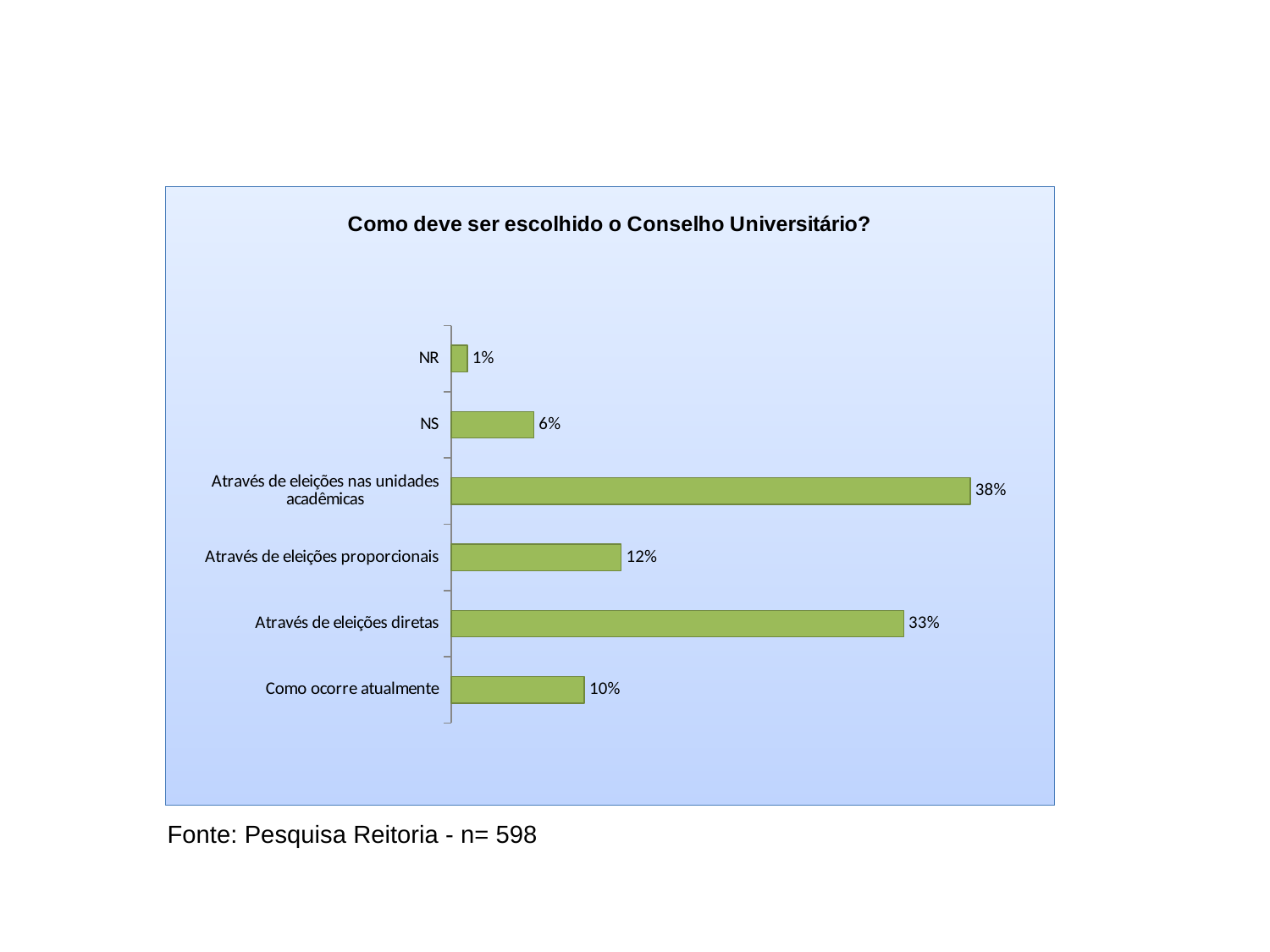
What is the difference between "Através de eleições proporcionais" and "NS"? 6% What is the value for "Através de eleições diretas"? 33% What is the title of the chart? Como deve ser escolhido o Conselho Universitário? What is the value for "Através de eleições nas unidades acadêmicas"? 38% What is the value for "NS"? 6% What is the value for "Como ocorre atualmente"? 10% How many categories are shown in the chart? 6 Which category has the lowest value? NR What is the difference between "Através de eleições nas unidades acadêmicas" and "Através de eleições diretas"? 5% Which is larger, "Através de eleições proporcionais" or "Como ocorre atualmente"? Através de eleições proporcionais Which category has the highest value? Através de eleições nas unidades acadêmicas What kind of chart is shown on the slide? Bar chart